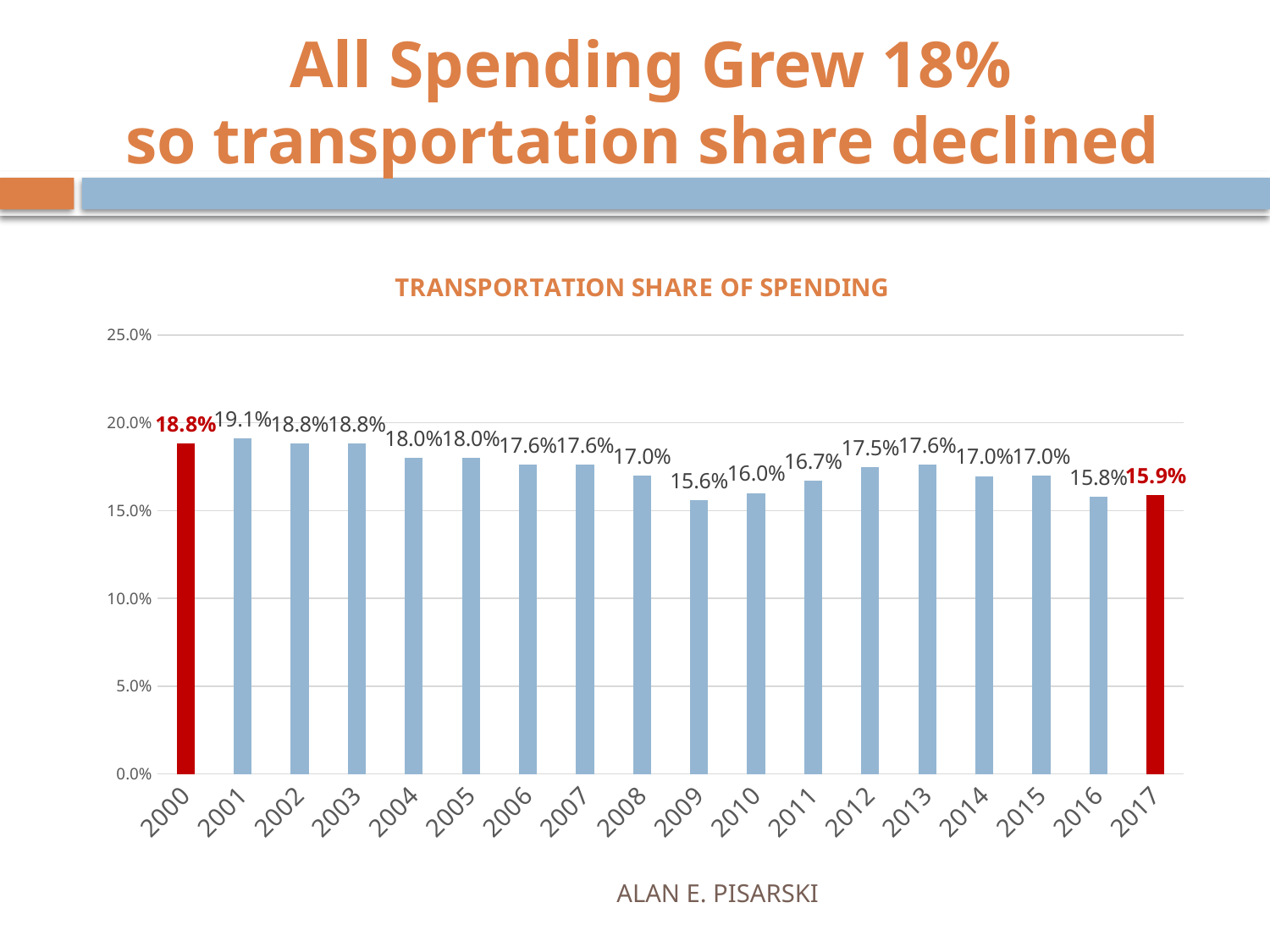
What type of chart is shown on the slide? Bar chart How many years are shown on the chart? 18 What is the difference between the transportation share of spending in 2000 and in 2017? 2.9% What is the transportation share of spending in 2009? 15.6% Which year has a larger transportation share of spending, 2011 or 2016? 2011 What is the transportation share of spending in 2012? 17.5% Overall, does the transportation share of spending rise or fall from 2000 to 2017? Fall What is the transportation share of spending in 2017? 15.9% What is the title of the chart? TRANSPORTATION SHARE OF SPENDING Which year has the lowest transportation share of spending? 2009 Which year has the highest transportation share of spending? 2001 What is the transportation share of spending in 2000? 18.8%